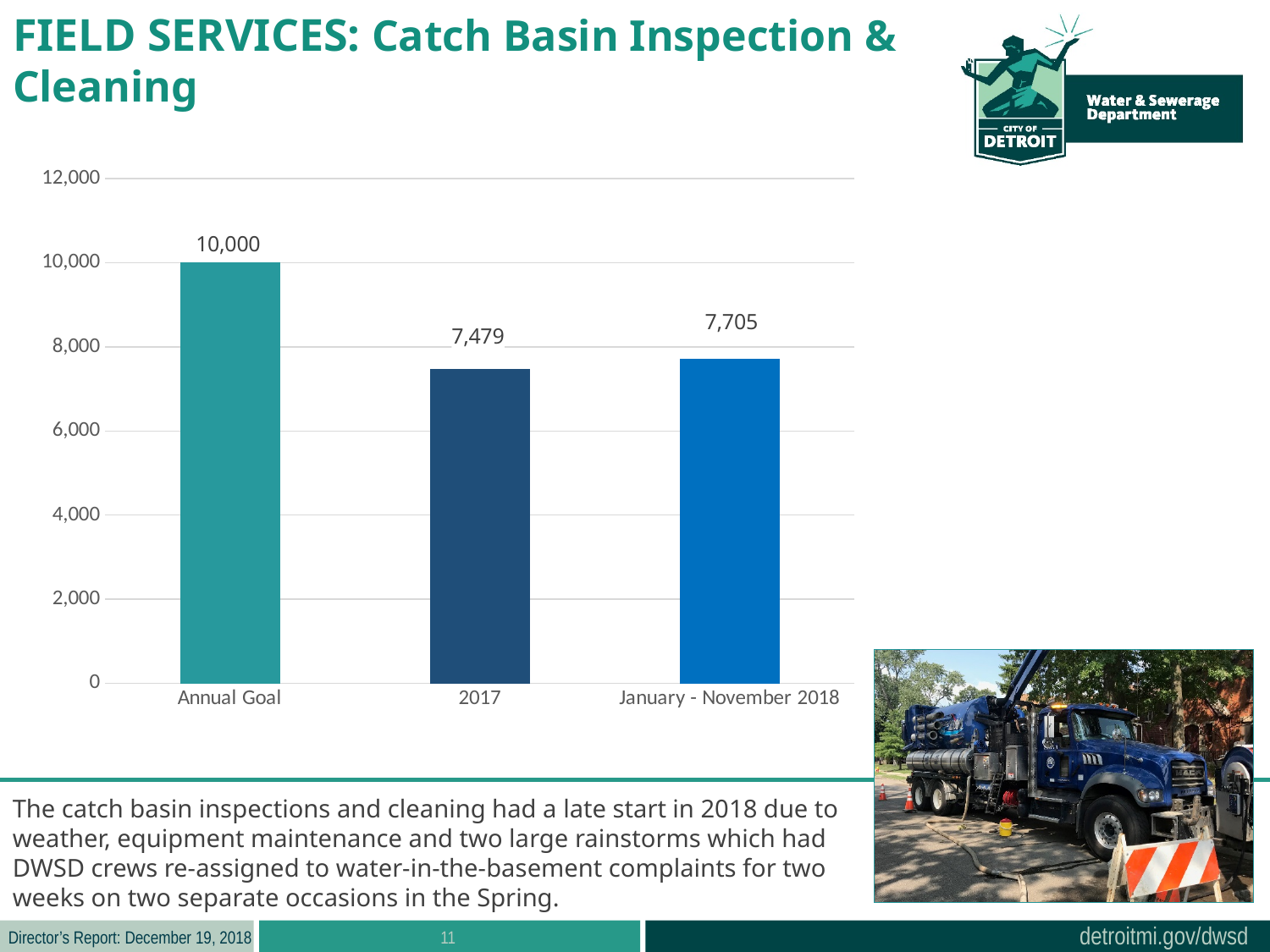
How many bars are shown in the chart? 3 What is the difference between the January - November 2018 value and the 2017 value? 226 Which is larger, the value for 2017 or the value for January - November 2018? January - November 2018 What is the value for January - November 2018? 7,705 What is the difference between the Annual Goal and the January - November 2018 value? 2,295 What is the value for 2017? 7,479 Which category has the lowest value? 2017 Which category has the highest value? Annual Goal What kind of chart is shown on the slide? bar chart Is the value for 2017 greater or less than 8,000? less What is the value for Annual Goal? 10,000 What is the maximum value shown on the vertical axis? 12,000